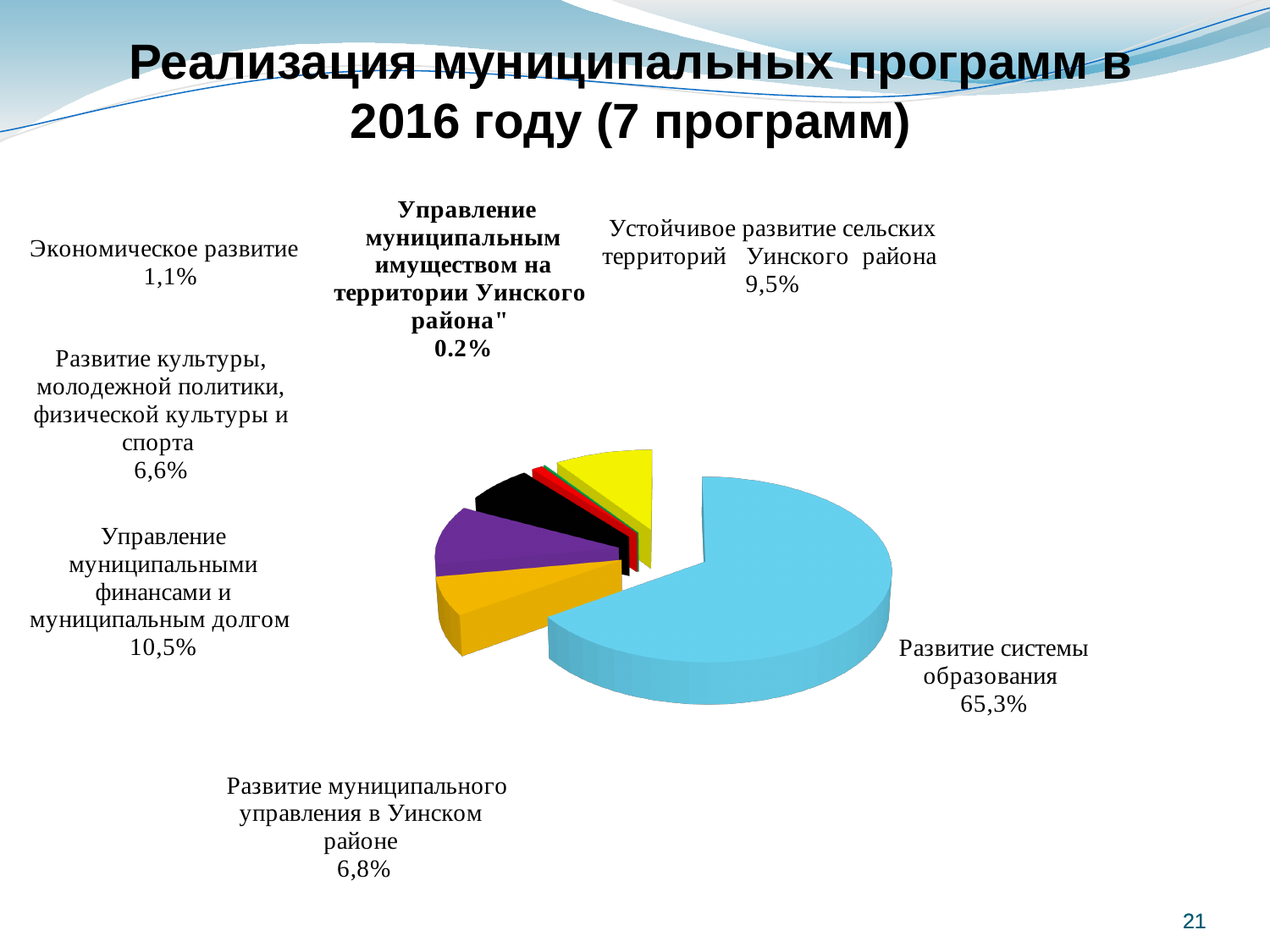
What is the value shown for "Устойчивое развитие сельских территорий Уинского района"? 9,5% What kind of chart is shown on the slide? pie chart Which program has the smallest share of the pie? Управление муниципальным имуществом на территории Уинского района What share of the pie does "Развитие системы образования" have? 65,3% How many slices does the pie chart have? 7 Which is larger: the share for "Развитие культуры, молодежной политики, физической культуры и спорта" or for "Устойчивое развитие сельских территорий Уинского района"? Устойчивое развитие сельских территорий Уинского района What is the value shown for "Управление муниципальными финансами и муниципальным долгом"? 10,5% What is the title of the slide containing the pie chart? Реализация муниципальных программ в 2016 году (7 программ) Which program has the largest share of the pie? Развитие системы образования What is the value shown for "Развитие муниципального управления в Уинском районе"? 6,8% What is the value shown for "Экономическое развитие"? 1,1% What is the difference between the shares of "Управление муниципальными финансами и муниципальным долгом" and "Развитие муниципального управления в Уинском районе"? 3,7%